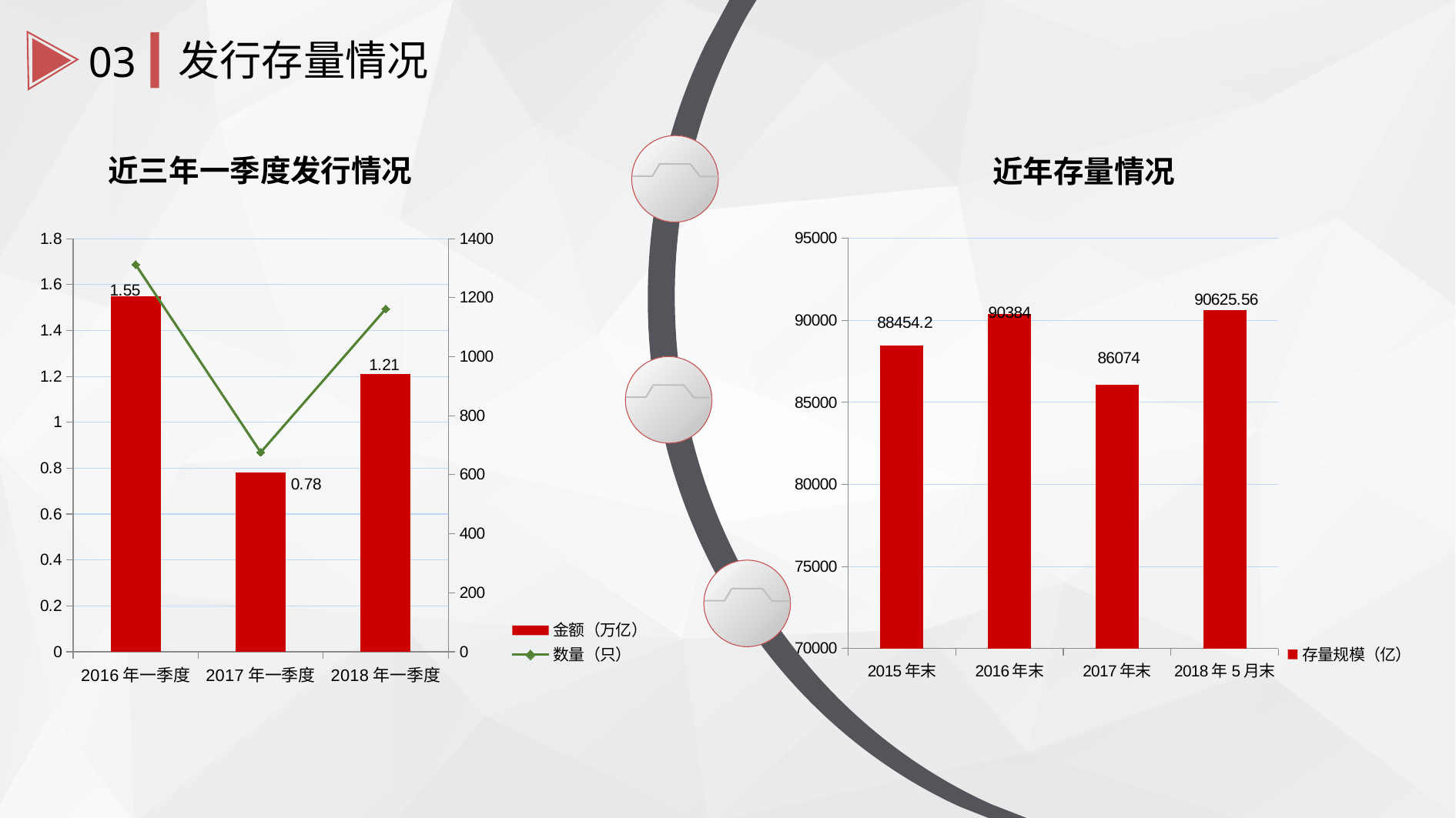
In the chart titled 近年存量情况, what is the 存量规模（亿） value for 2018 年 5 月末? 90625.56 In the chart titled 近三年一季度发行情况, how many series does the legend list? 2 In the chart titled 近三年一季度发行情况, is the 数量（只） value for 2017 年一季度 greater or less than 800? less In the chart titled 近年存量情况, which period has the highest 存量规模（亿） value? 2018 年 5 月末 In the chart titled 近三年一季度发行情况, what is the difference between the 金额（万亿） values for 2016 年一季度 and 2018 年一季度? 0.34 In the chart titled 近三年一季度发行情况, what is the 金额（万亿） value for 2017 年一季度? 0.78 In the chart titled 近年存量情况, how many categories are shown on the x axis? 4 What kind of chart is the chart titled 近年存量情况? bar chart In the chart titled 近三年一季度发行情况, which quarter has the lowest 金额（万亿） value? 2017 年一季度 In the chart titled 近年存量情况, which is larger, the value for 2015 年末 or the value for 2017 年末? 2015 年末 In the chart titled 近年存量情况, what is the 存量规模（亿） value for 2017 年末? 86074 In the chart titled 近三年一季度发行情况, what is the 金额（万亿） value for 2016 年一季度? 1.55